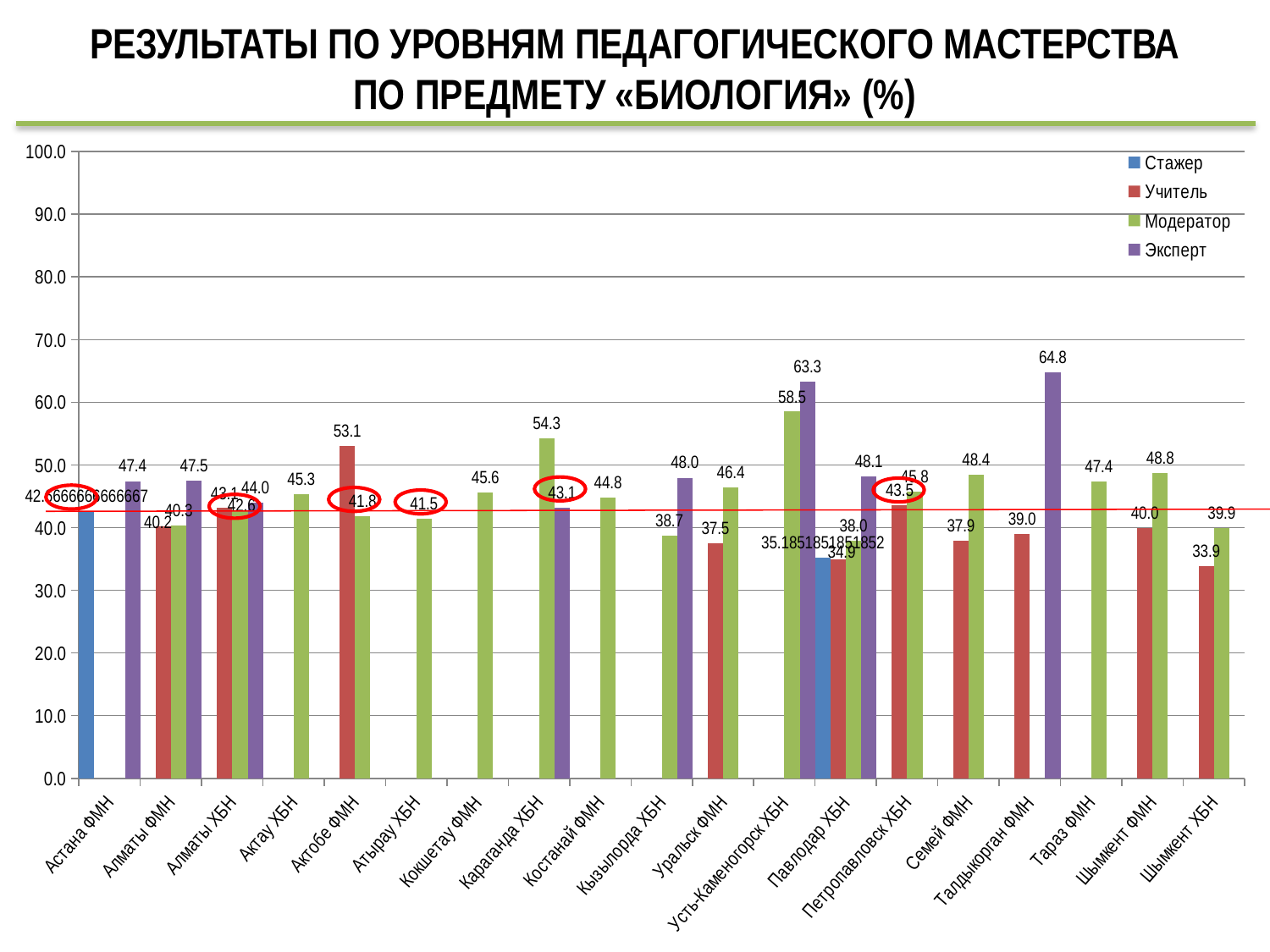
What kind of chart is shown on the slide? Bar chart For Семей ФМН, which is larger: the Учитель value or the Модератор value? Модератор What is the difference between the Эксперт and Модератор values for Усть-Каменогорск ХБН? 4.8 Which category has the highest Модератор value? Усть-Каменогорск ХБН What is the Учитель value for Актобе ФМН? 53.1 How many categories are shown on the x axis? 19 How many series does the legend list? 4 What is the Эксперт value for Талдыкорган ФМН? 64.8 Which category has the highest Эксперт value? Талдыкорган ФМН Which series is shown in purple in the legend? Эксперт What is the Модератор value for Усть-Каменогорск ХБН? 58.5 Which category has the lowest Учитель value? Шымкент ХБН